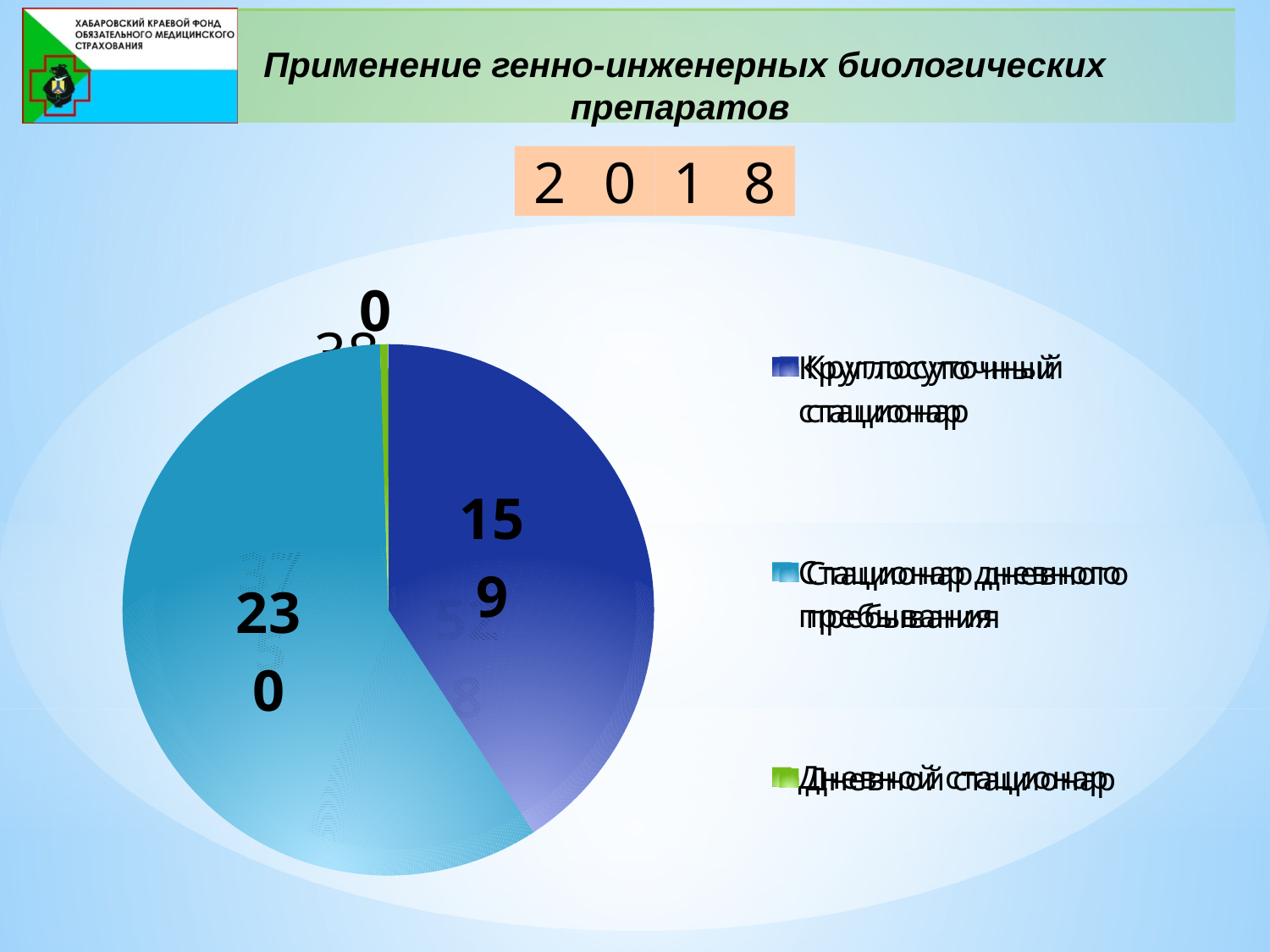
How many categories does the pie chart show? 3 What colour is the slice for Круглосуточный стационар? dark blue Which category has the largest slice in the pie chart? Стационар дневного пребывания What is the value for Стационар дневного пребывания in the pie chart? 230 What is the value for Круглосуточный стационар in the pie chart? 159 What is the difference between the values for Стационар дневного пребывания and Круглосуточный стационар? 71 How many entries does the legend list? 3 Which category has the smallest slice in the pie chart? Дневной стационар Which is larger: the value for Круглосуточный стационар or for Стационар дневного пребывания? Стационар дневного пребывания What kind of chart is shown on the slide? pie chart Which year is shown above the chart? 2018